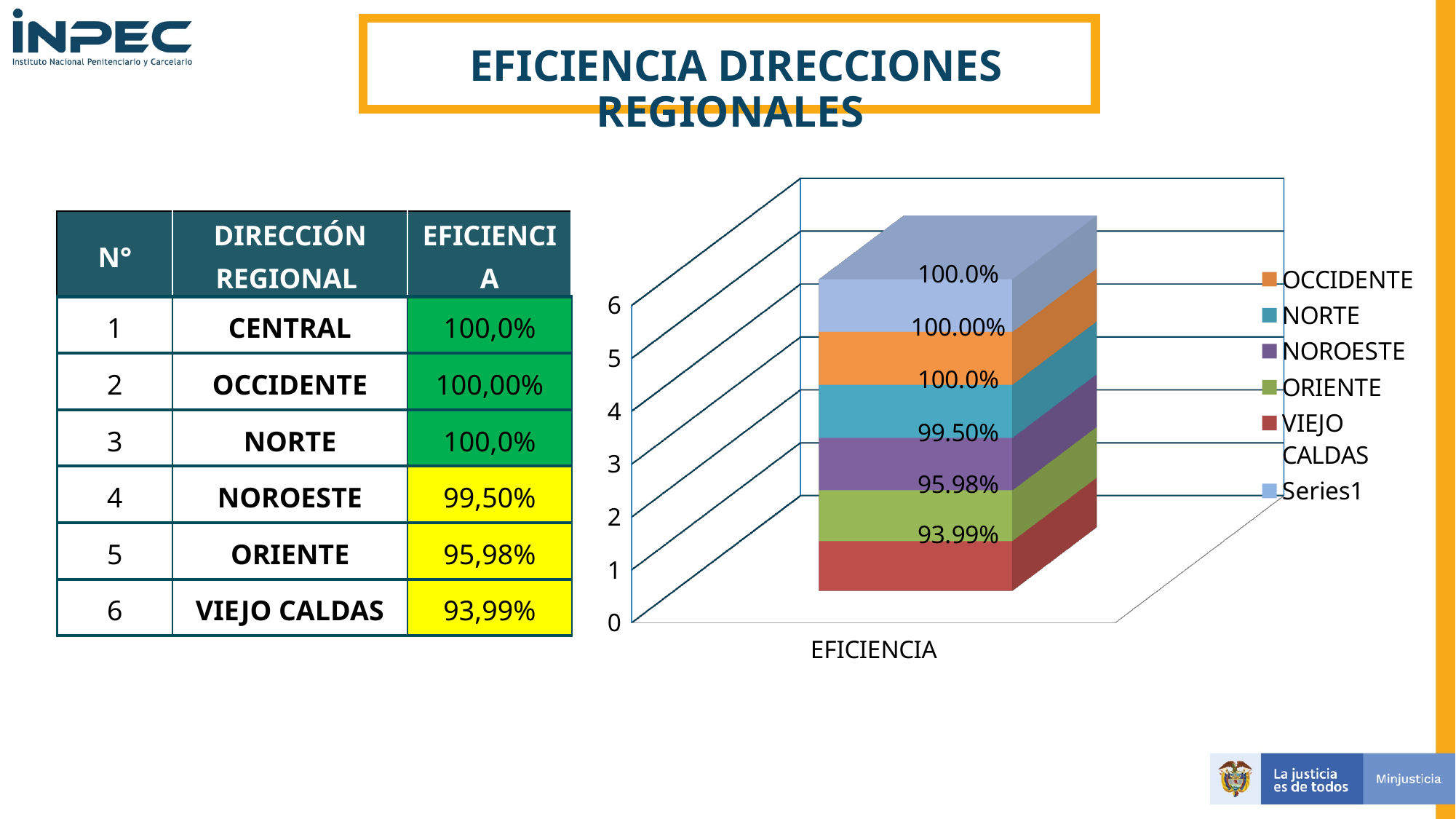
What is the value labelled for VIEJO CALDAS in the chart? 93.99% How many categories are shown on the x axis of the chart? 1 How many series does the chart legend list? 6 What is the difference between the labelled values for NOROESTE and ORIENTE in the chart? 3.52 percentage points What is the value labelled for OCCIDENTE in the chart? 100.00% What type of chart is shown on the slide? Bar chart What is the value labelled for NOROESTE in the chart? 99.50% Which is larger in the chart, the value for ORIENTE or the value for VIEJO CALDAS? ORIENTE Which series has the lowest labelled value in the chart? VIEJO CALDAS Which legend entry in the chart is shown in light blue? Series1 What is the category label shown on the x axis of the chart? EFICIENCIA What is the value labelled for ORIENTE in the chart? 95.98%